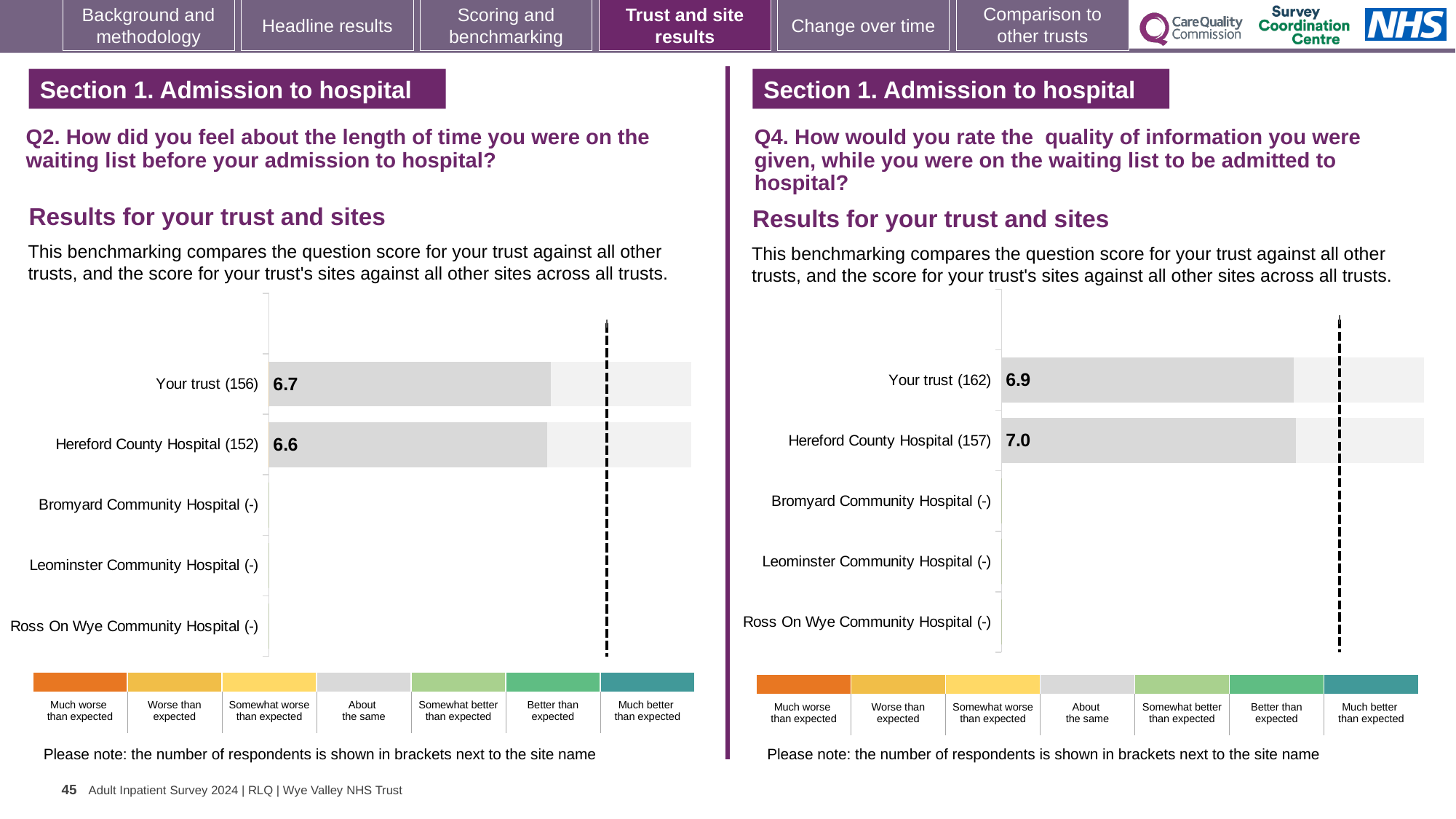
On the Q2 chart (left), what is the difference between the score for Your trust and the score for Hereford County Hospital? 0.1 On the Q2 chart (left), what is the score for Hereford County Hospital? 6.6 On the Q2 chart (left), how many respondents are shown in brackets for Your trust? 156 On the Q4 chart (right), which has the higher score, Your trust or Hereford County Hospital? Hereford County Hospital On the Q4 chart (right), what is the score for Hereford County Hospital? 7.0 On the Q4 chart (right), how many respondents are shown in brackets for Hereford County Hospital? 157 What kind of chart is used on the Q4 chart (right)? Bar chart On the Q2 chart (left), which has the higher score, Your trust or Hereford County Hospital? Your trust How many site/trust categories are listed on the Q2 chart (left)? 5 On the Q2 chart (left), what is the score for Your trust? 6.7 On the Q4 chart (right), what is the score for Your trust? 6.9 On the Q2 chart (left), how many sites have no score shown (marked with '-')? 3